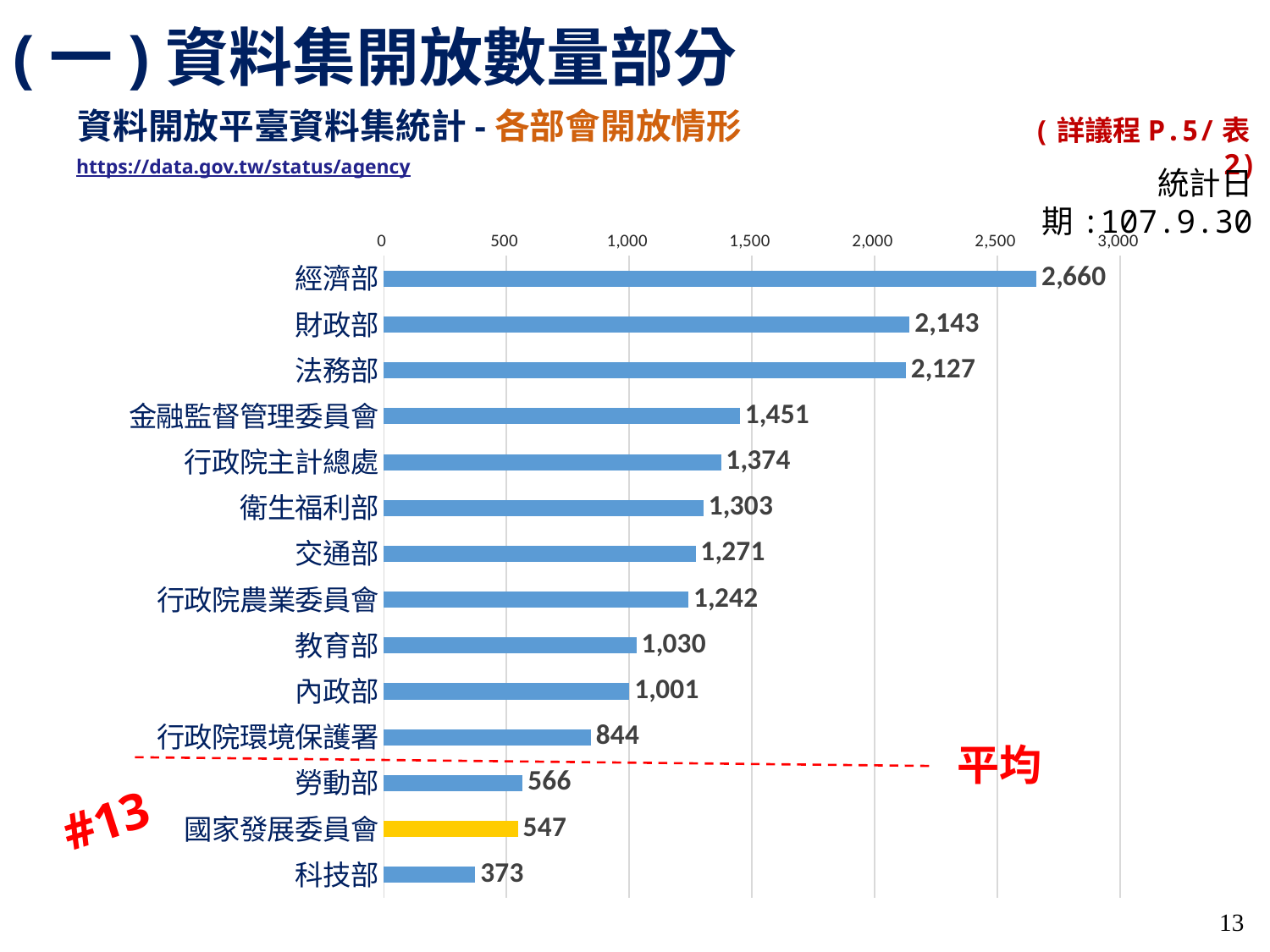
Which category's bar is coloured yellow instead of blue? 國家發展委員會 What kind of chart is shown on the slide? bar chart Which is larger, the value for 教育部 or the value for 內政部? 教育部 What is the value for 國家發展委員會? 547 Which category has the highest value? 經濟部 What is the value for 經濟部? 2,660 Is the value for 金融監督管理委員會 greater or less than 1,500? less How many categories are shown in the chart? 14 What is the value for 行政院環境保護署? 844 What is the difference between the values for 勞動部 and 國家發展委員會? 19 What is the difference between the values for 財政部 and 法務部? 16 Which category has the lowest value? 科技部